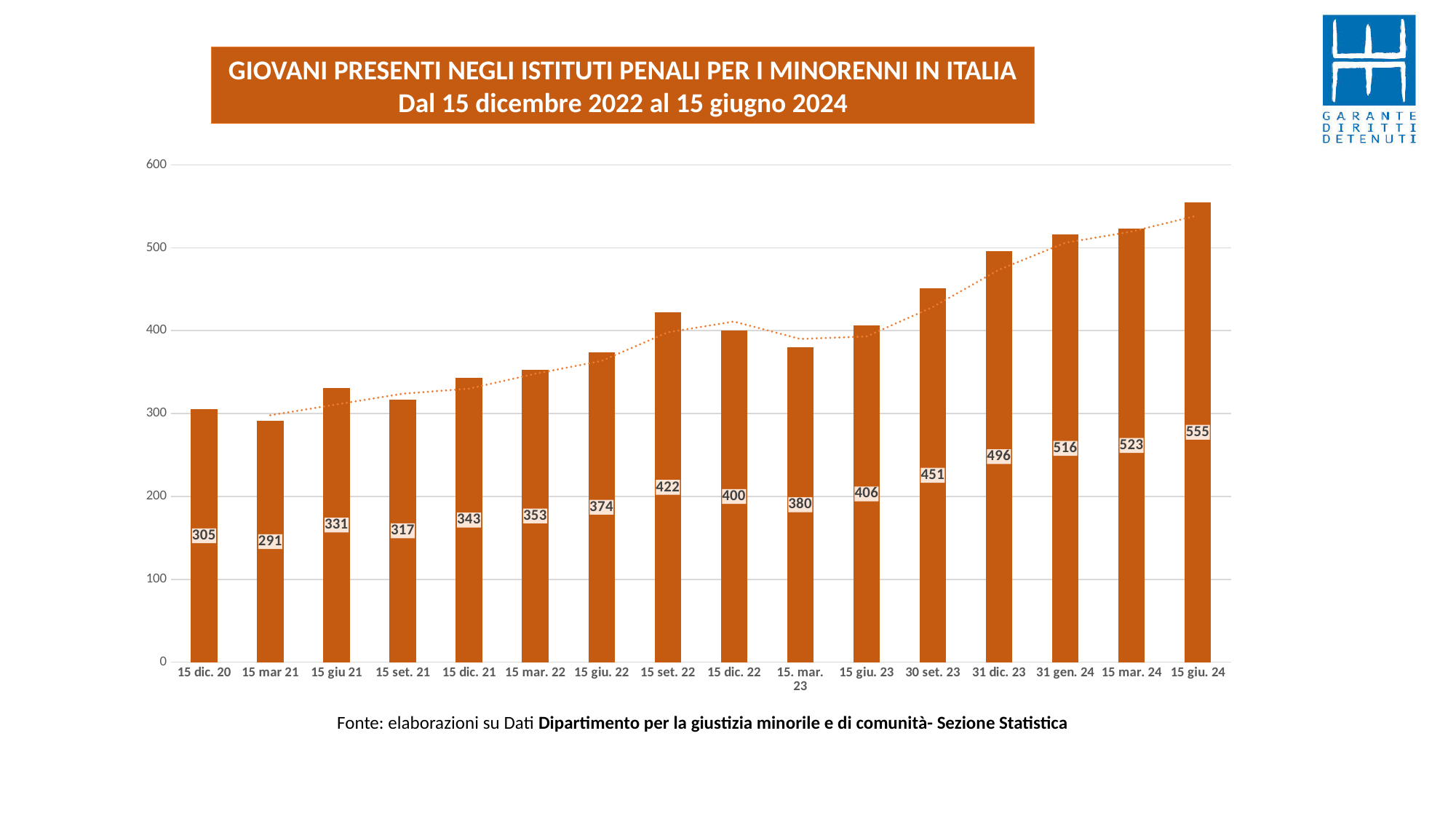
What is the value for 15 dic. 20? 305 What kind of chart is this? bar chart What is the title of the chart? GIOVANI PRESENTI NEGLI ISTITUTI PENALI PER I MINORENNI IN ITALIA Dal 15 dicembre 2022 al 15 giugno 2024 What is the difference between the values for 15 giu. 24 and 15 dic. 20? 250 Do the values generally rise or fall from 15 dic. 20 to 15 giu. 24? rise What is the difference between the values for 15 set. 22 and 15 dic. 22? 22 What is the value for 15 set. 22? 422 Which date has the lowest value? 15 mar 21 Which is larger, the value for 15 dic. 22 or the value for 15. mar. 23? 15 dic. 22 Which date has the highest value? 15 giu. 24 How many dates are shown on the x axis? 16 What is the value for 15 giu. 24? 555